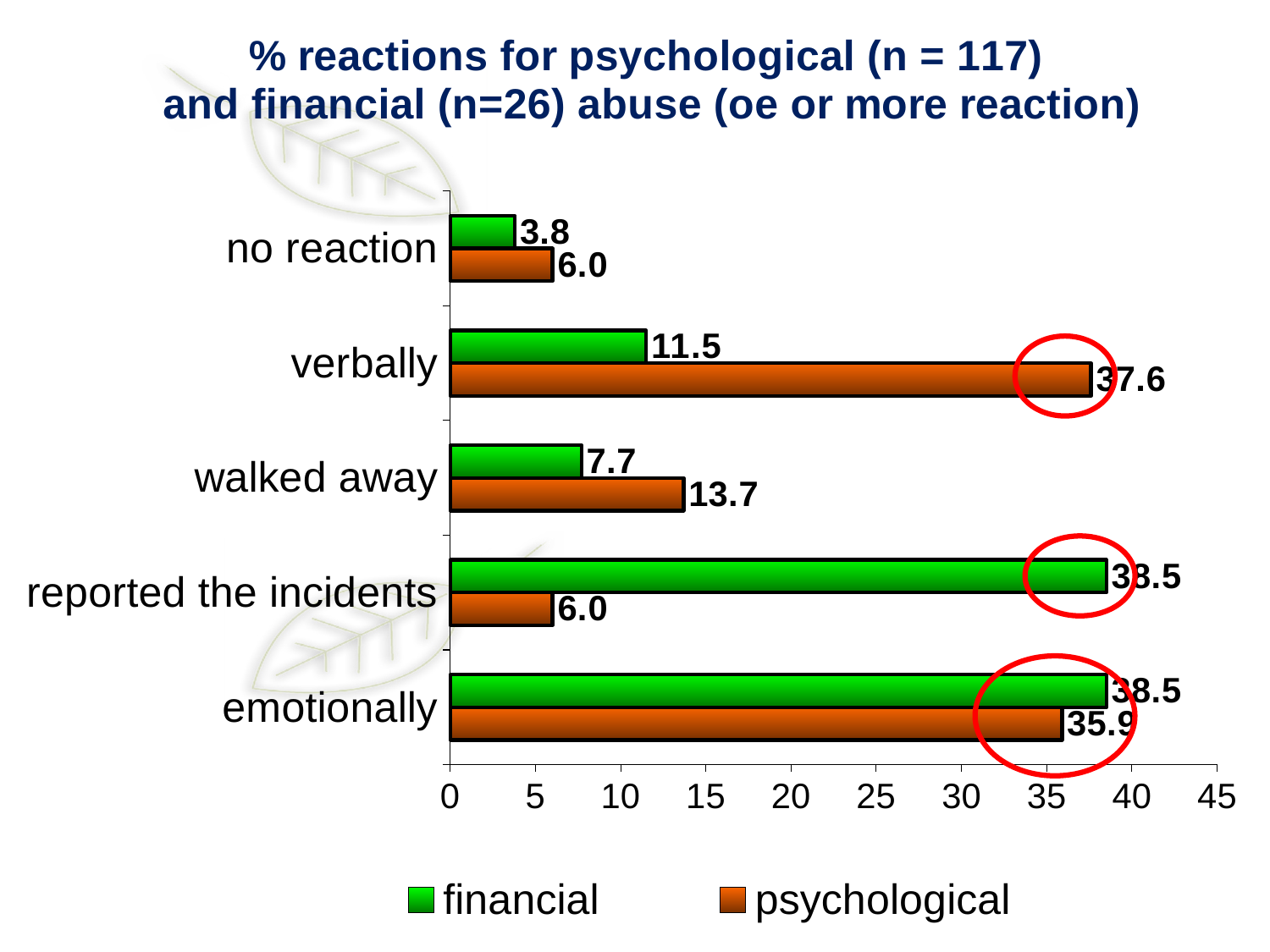
Which category has the lowest financial value? no reaction Which category has the highest psychological value? verbally Which colour represents the psychological series? orange What is the difference between the psychological and financial values for 'verbally'? 26.1 What kind of chart is shown on the slide? bar chart What is the psychological value for 'walked away'? 13.7 How many categories are shown on the chart? 5 What is the financial value for 'verbally'? 11.5 What is the psychological value for 'emotionally'? 35.9 For 'reported the incidents', which series has the larger value, financial or psychological? financial What is the financial value for 'no reaction'? 3.8 How many series does the legend list? 2